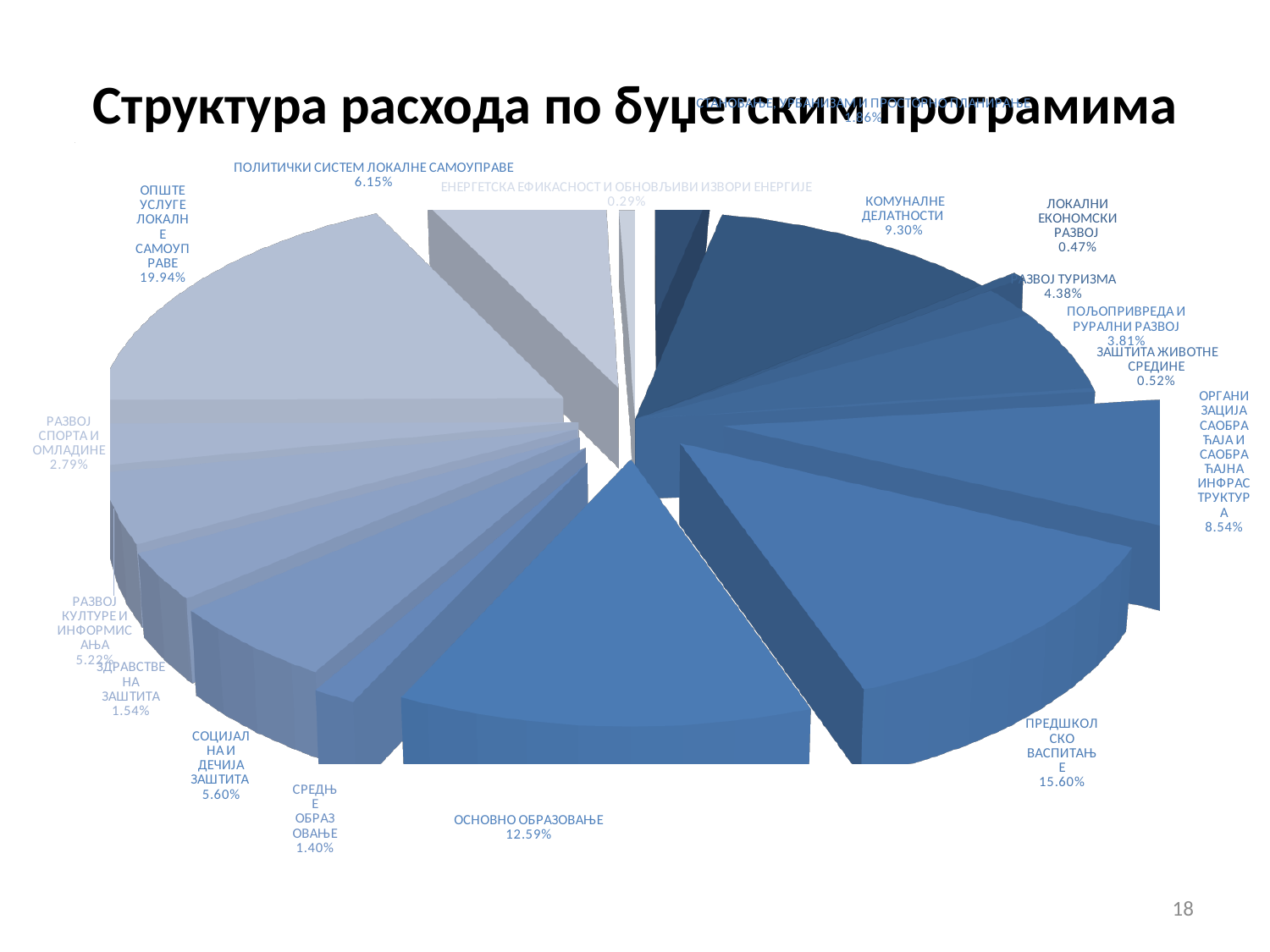
What type of chart is shown on the slide? Pie chart Which has a larger share: ПРЕДШКОЛСКО ВАСПИТАЊЕ or ОСНОВНО ОБРАЗОВАЊЕ? ПРЕДШКОЛСКО ВАСПИТАЊЕ What percentage is shown for ОСНОВНО ОБРАЗОВАЊЕ? 12.59% What is the difference in percentage points between ПРЕДШКОЛСКО ВАСПИТАЊЕ and ОСНОВНО ОБРАЗОВАЊЕ? 3.01 percentage points Which program has the largest share of expenditure? ОПШТЕ УСЛУГЕ ЛОКАЛНЕ САМОУПРАВЕ Which program has the smallest share of expenditure? ЕНЕРГЕТСКА ЕФИКАСНОСТ И ОБНОВЉИВИ ИЗВОРИ ЕНЕРГИЈЕ What percentage is shown for ПРЕДШКОЛСКО ВАСПИТАЊЕ? 15.60% What percentage is shown for РАЗВОЈ ТУРИЗМА? 4.38% What is the title of the chart on the slide? Структура расхода по буџетским програмима What share of expenditure goes to ОПШТЕ УСЛУГЕ ЛОКАЛНЕ САМОУПРАВЕ? 19.94% What is the difference in percentage points between ОПШТЕ УСЛУГЕ ЛОКАЛНЕ САМОУПРАВЕ and ПРЕДШКОЛСКО ВАСПИТАЊЕ? 4.34 percentage points What share does КОМУНАЛНЕ ДЕЛАТНОСТИ have in the pie chart? 9.30%